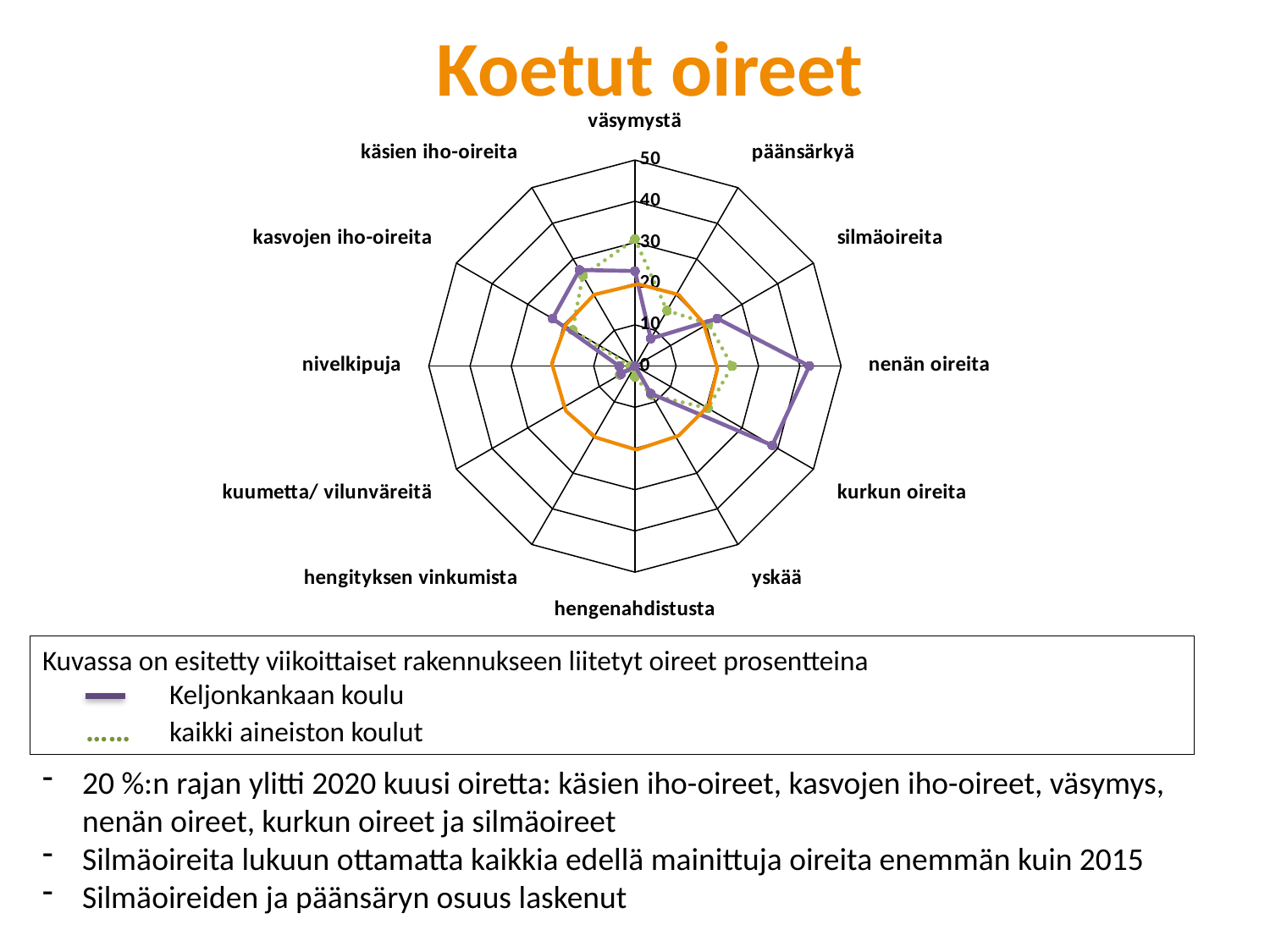
How many symptom categories are plotted around the radar chart? 12 Which series is drawn with the green dotted line? kaikki aineiston koulut Is the Keljonkankaan koulu value for nenän oireita greater or less than 30? greater Is the Keljonkankaan koulu value for kurkun oireita greater or less than 30? greater For nenän oireita, which series has the larger value, Keljonkankaan koulu or kaikki aineiston koulut? Keljonkankaan koulu How many series does the legend below the chart list? 2 What kind of chart is shown on the slide? radar chart For Keljonkankaan koulu, which is larger, the value for nenän oireita or the value for hengenahdistusta? nenän oireita Is the kaikki aineiston koulut value for väsymystä greater or less than 20? greater What is the title of the chart? Koetut oireet